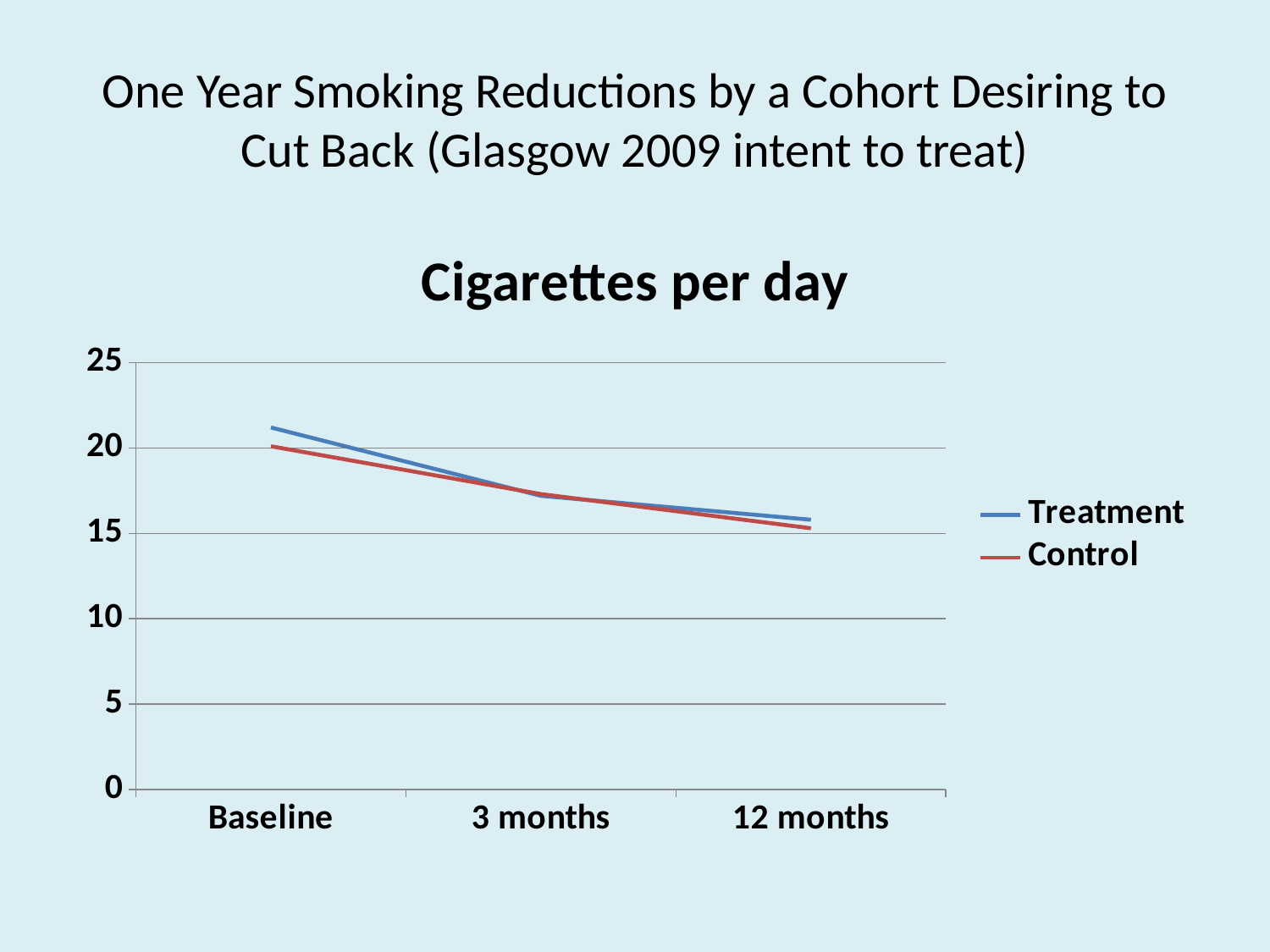
Is the Treatment value at Baseline greater or less than 20? greater Is the Treatment value at 3 months greater or less than 20? less Do the Control values rise or fall from Baseline to 12 months? fall At Baseline, which series has the higher value, Treatment or Control? Treatment Which series is drawn in red? Control At which time point is the Control series lowest? 12 months Do the Treatment values rise or fall from Baseline to 12 months? fall What kind of chart is shown on the slide? line chart What is the title of the chart? Cigarettes per day At which time point is the Treatment series highest? Baseline How many time points are plotted along the x axis? 3 How many series does the legend list? 2